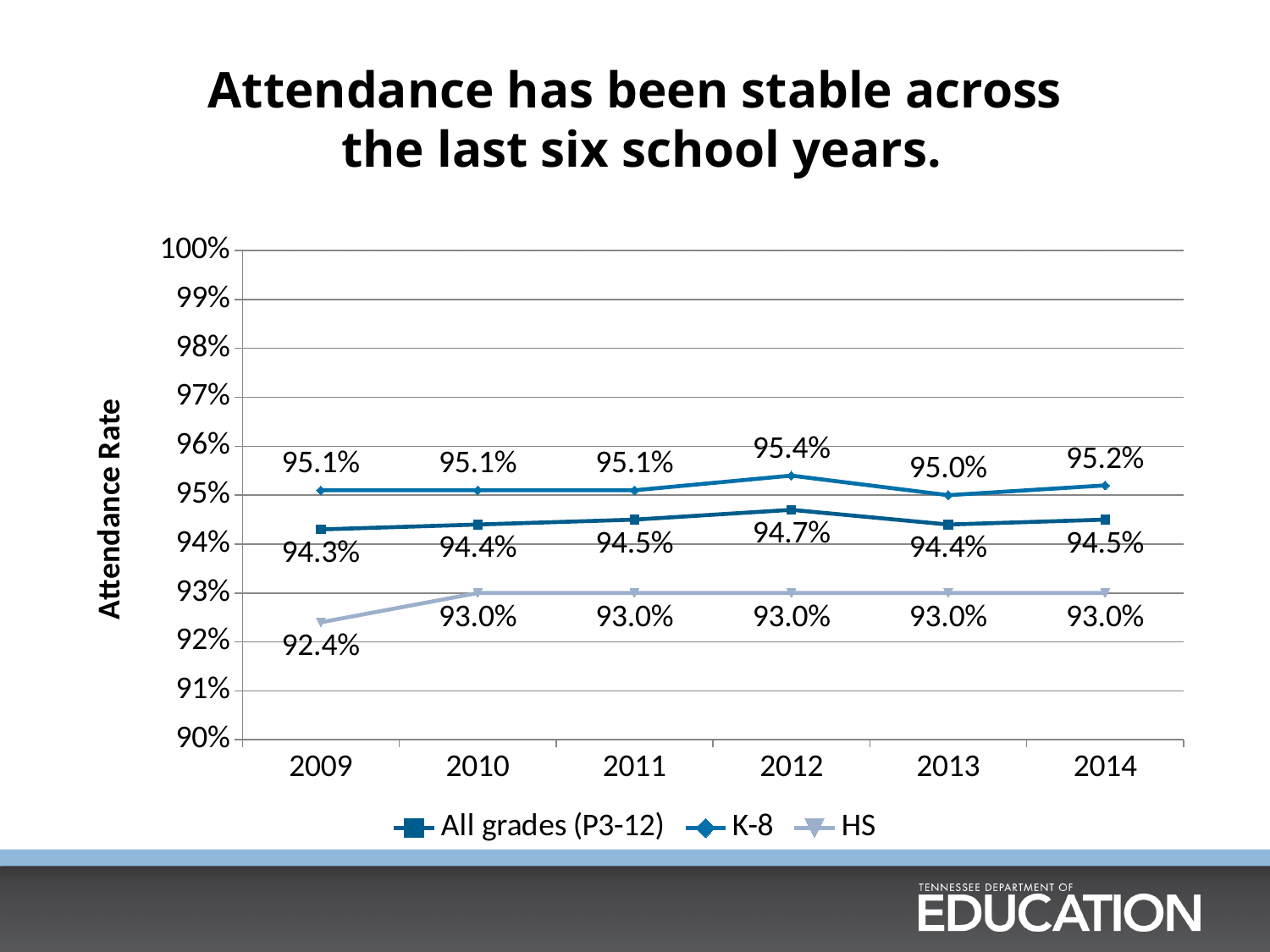
Did the HS attendance rate rise or fall from 2009 to 2010? Rise In which year was the HS attendance rate lowest? 2009 How many series does the legend list? 3 How many years are shown on the x axis? 6 What was the attendance rate for All grades (P3-12) in 2014? 94.5% What is the label on the vertical axis? Attendance Rate What kind of chart is shown on the slide? Line chart What was the K-8 attendance rate in 2012? 95.4% In which year was the K-8 attendance rate highest? 2012 Which series had the higher attendance rate in 2013, K-8 or All grades (P3-12)? K-8 What was the HS attendance rate in 2009? 92.4% What is the difference between the K-8 and HS attendance rates in 2012? 2.4%